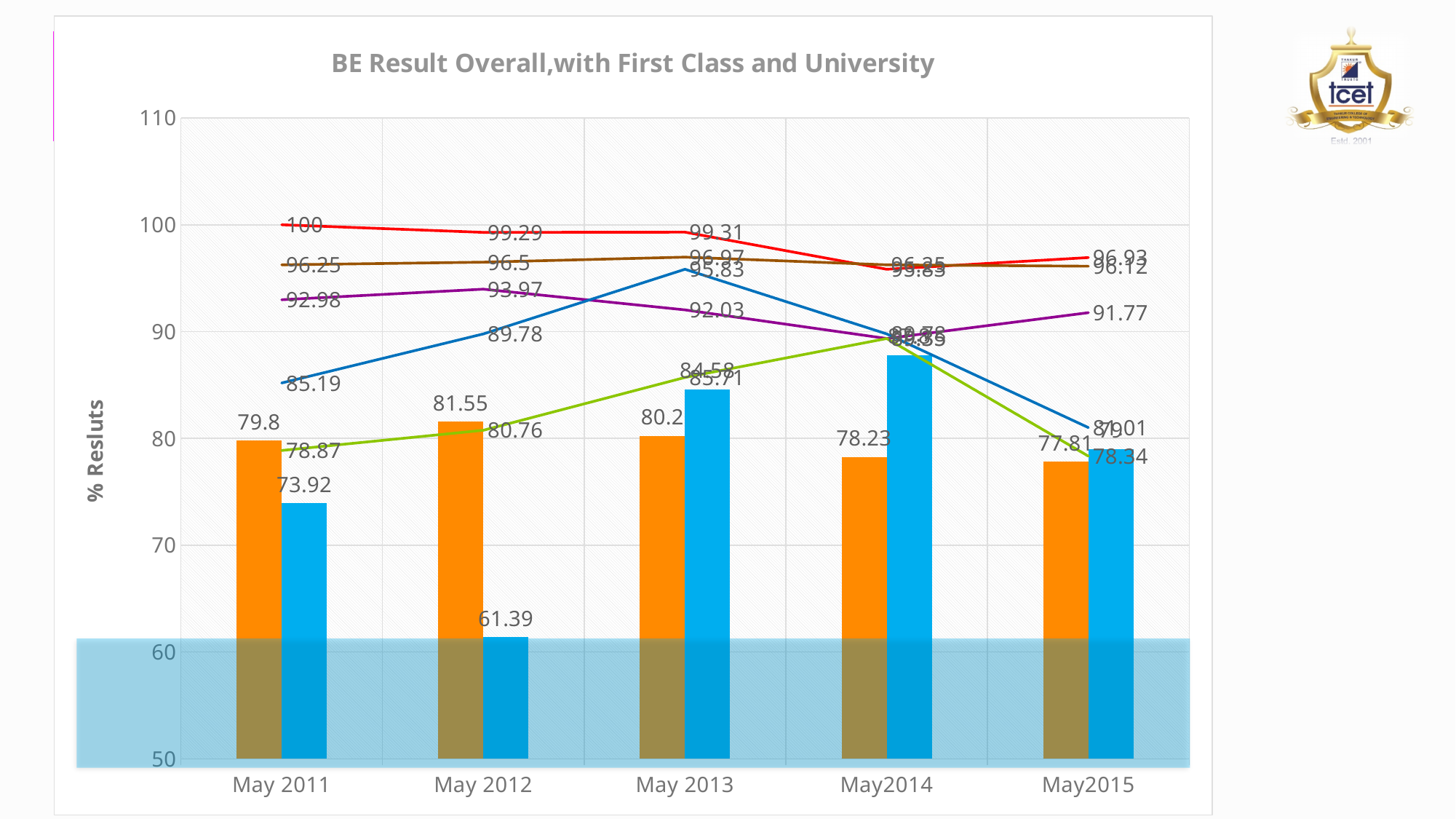
What is the value of the purple line at May2015? 91.77 Is the value of the blue bar for May2014 greater or less than 80? greater What is the difference between the orange bar values for May 2012 and May 2011? 1.75 What is the value of the red line at May 2011? 100 In which category is the blue bar lowest? May 2012 What is the value of the orange bar for May 2012? 81.55 What is the value of the blue bar for May 2013? 84.58 What is the title of the chart? BE Result Overall,with First Class and University How many categories are shown on the x axis? 5 In which category is the orange bar highest? May 2012 What is the value of the blue bar for May 2012? 61.39 What kind of chart is shown on the slide? Combined bar and line chart